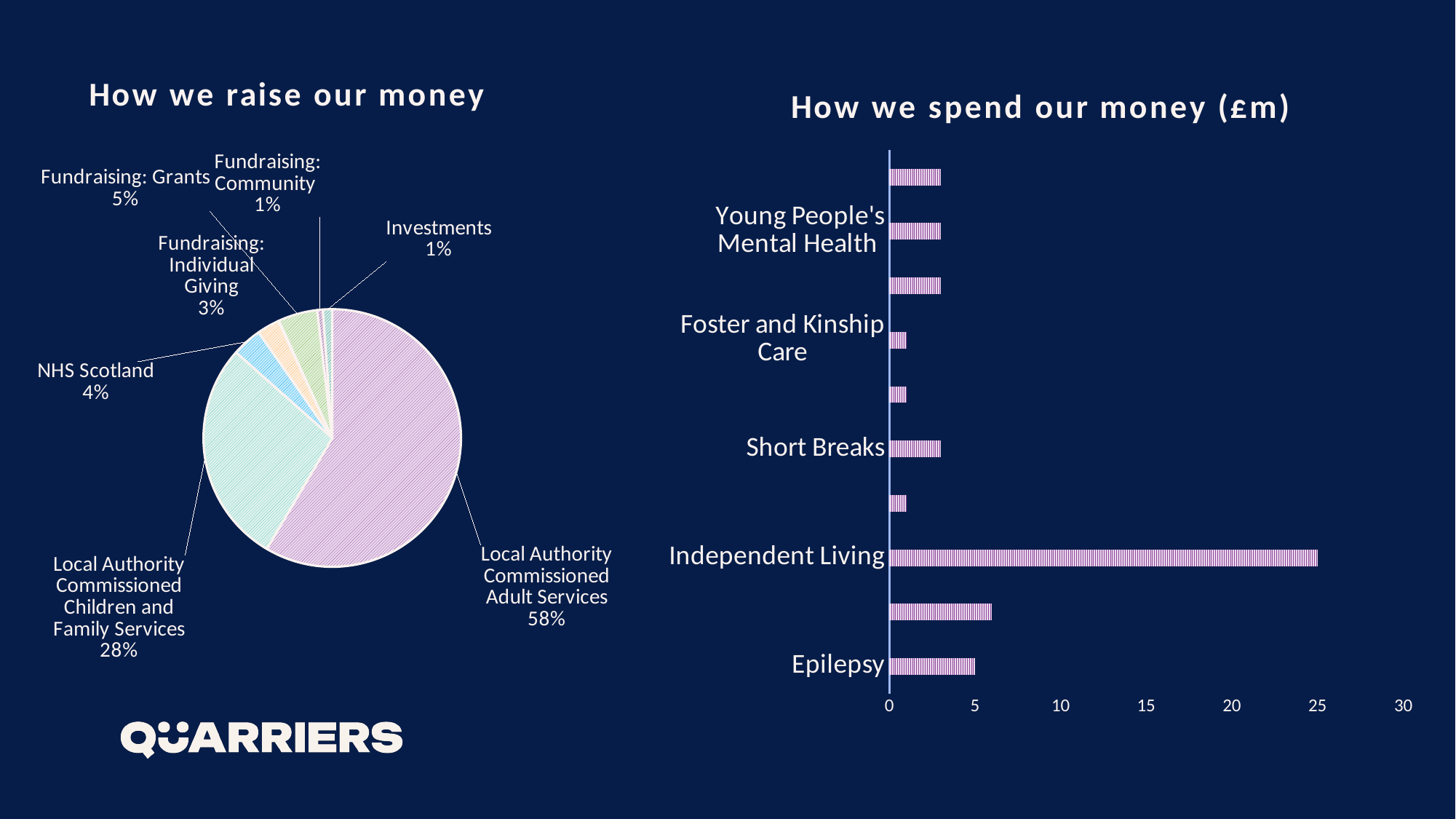
In the pie chart 'How we raise our money', which is larger: NHS Scotland or Fundraising: Grants? Fundraising: Grants In the chart 'How we spend our money (£m)', is the value for Independent Living greater or less than 20? greater In the pie chart 'How we raise our money', what share comes from Local Authority Commissioned Adult Services? 58% In the pie chart 'How we raise our money', which source is the largest? Local Authority Commissioned Adult Services In the pie chart 'How we raise our money', what share comes from Fundraising: Grants? 5% In the pie chart 'How we raise our money', what share comes from NHS Scotland? 4% In the chart 'How we spend our money (£m)', is the value for Epilepsy greater or less than 10? less In the chart 'How we spend our money (£m)', which labelled category has the highest spend? Independent Living In the chart 'How we spend our money (£m)', which is larger: Epilepsy or Foster and Kinship Care? Epilepsy In the pie chart 'How we raise our money', how many percentage points larger is Local Authority Commissioned Adult Services than Local Authority Commissioned Children and Family Services? 30 percentage points What kind of chart is 'How we spend our money (£m)'? Bar chart